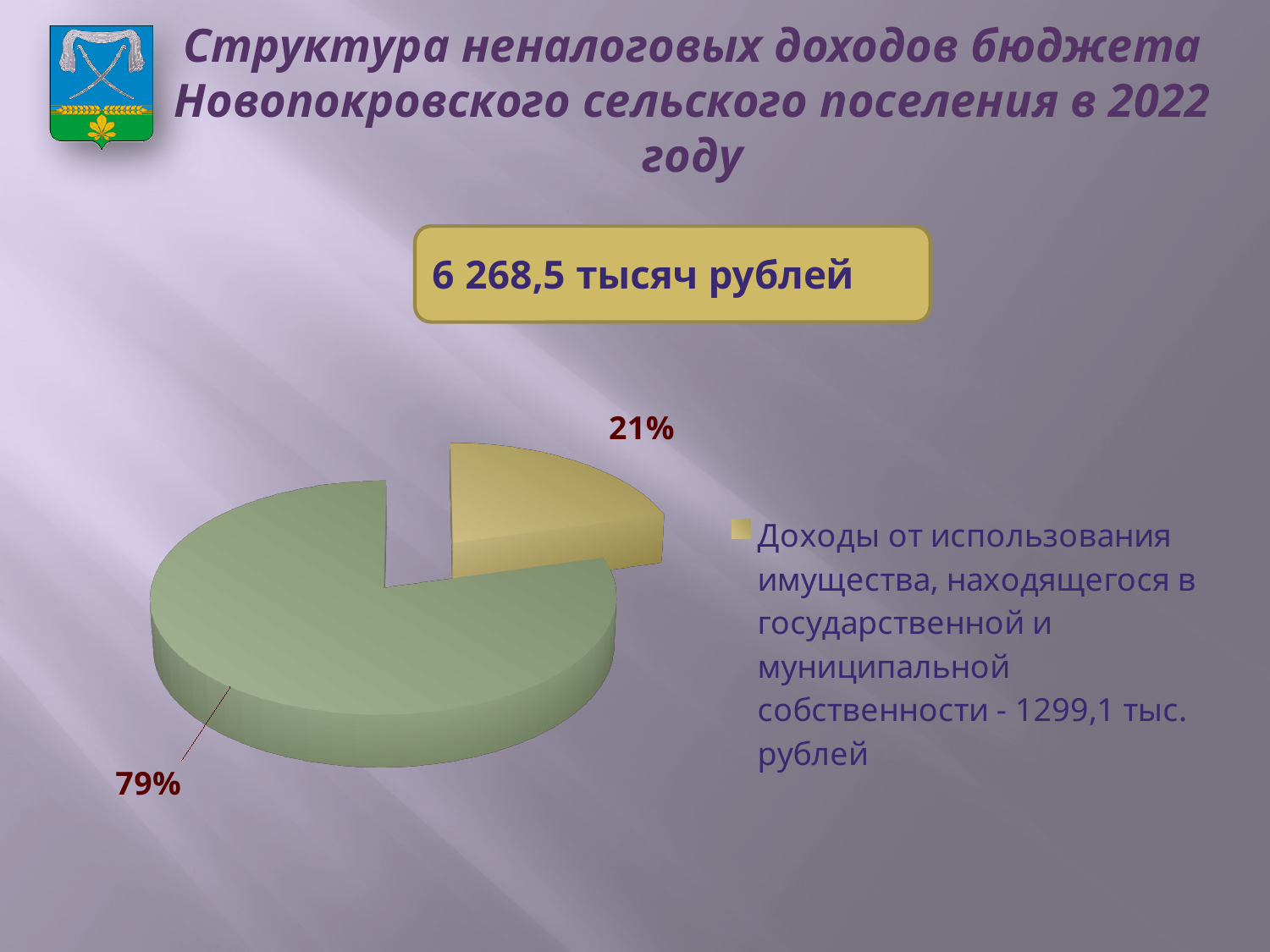
What total amount is shown in the box above the pie chart? 6 268,5 тысяч рублей How many slices does the pie chart have? 2 How many entries does the legend of the pie chart list? 1 Which slice of the pie chart is the smallest? the yellow slice (21%) What is the difference in percentage points between the green slice and the yellow slice? 58 What percentage is shown for the yellow slice of the pie chart? 21% Which slice of the pie chart is the largest? the green slice (79%) Which is larger, the yellow slice or the green slice of the pie chart? the green slice What amount in thousand rubles is given in the legend for 'Доходы от использования имущества, находящегося в государственной и муниципальной собственности'? 1299,1 тыс. рублей What kind of chart is shown on the slide? pie chart What share of the pie is labelled for 'Доходы от использования имущества, находящегося в государственной и муниципальной собственности'? 21% What percentage is shown for the green slice of the pie chart? 79%